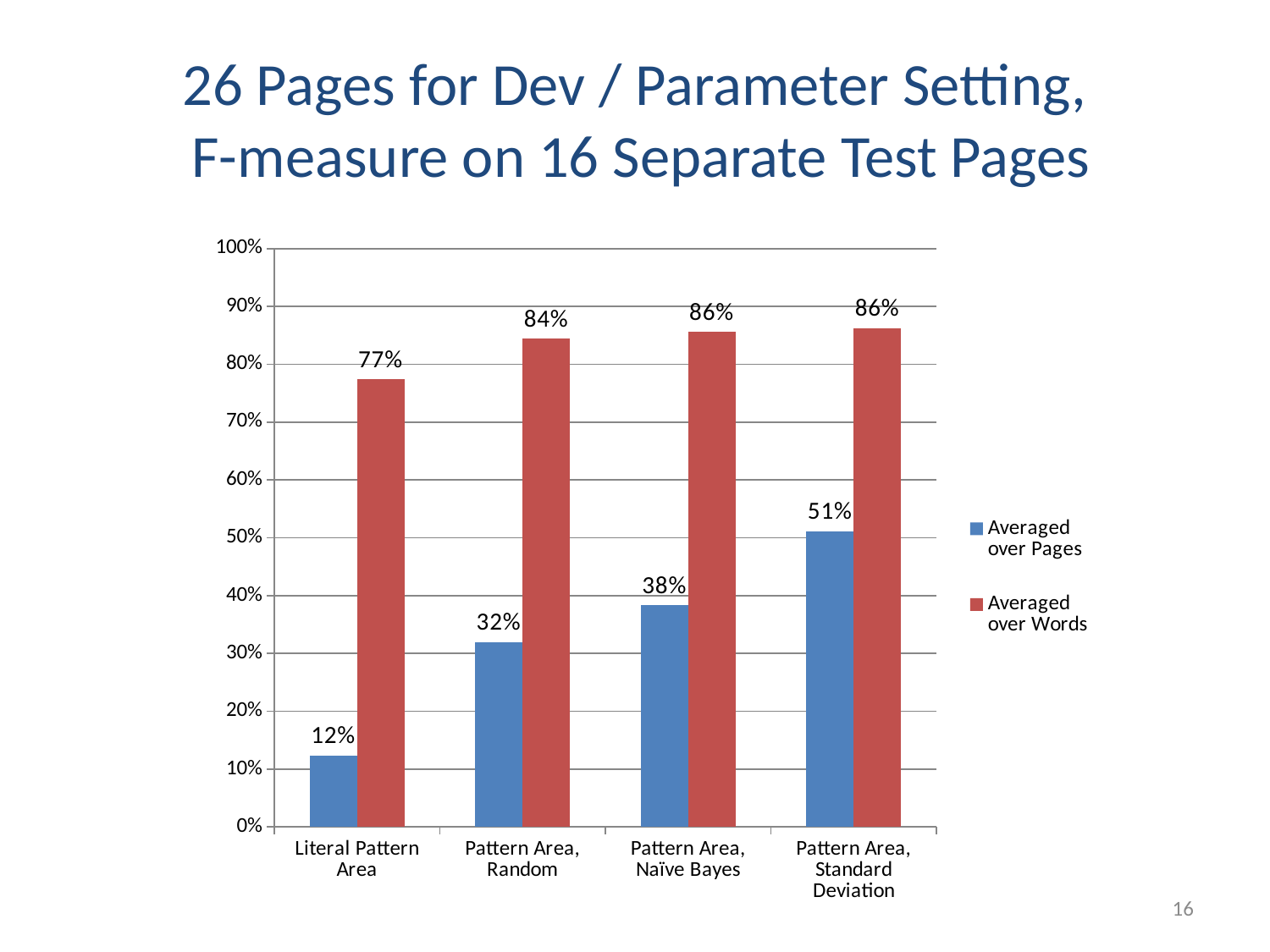
Which category has the highest 'Averaged over Pages' value? Pattern Area, Standard Deviation What kind of chart is shown on the slide? Bar chart Which category has the lowest 'Averaged over Words' value? Literal Pattern Area What is the difference between the 'Averaged over Words' and 'Averaged over Pages' values for Pattern Area, Naïve Bayes? 48% What is the 'Averaged over Words' value for Pattern Area, Random? 84% What is the 'Averaged over Pages' value for Literal Pattern Area? 12% Which category has the lowest 'Averaged over Pages' value? Literal Pattern Area How many series does the legend list? 2 Which is larger for Pattern Area, Random: 'Averaged over Pages' or 'Averaged over Words'? Averaged over Words What is the 'Averaged over Pages' value for Pattern Area, Standard Deviation? 51% How many categories are shown on the x axis? 4 Do the 'Averaged over Pages' values rise or fall from left to right along the x axis? Rise